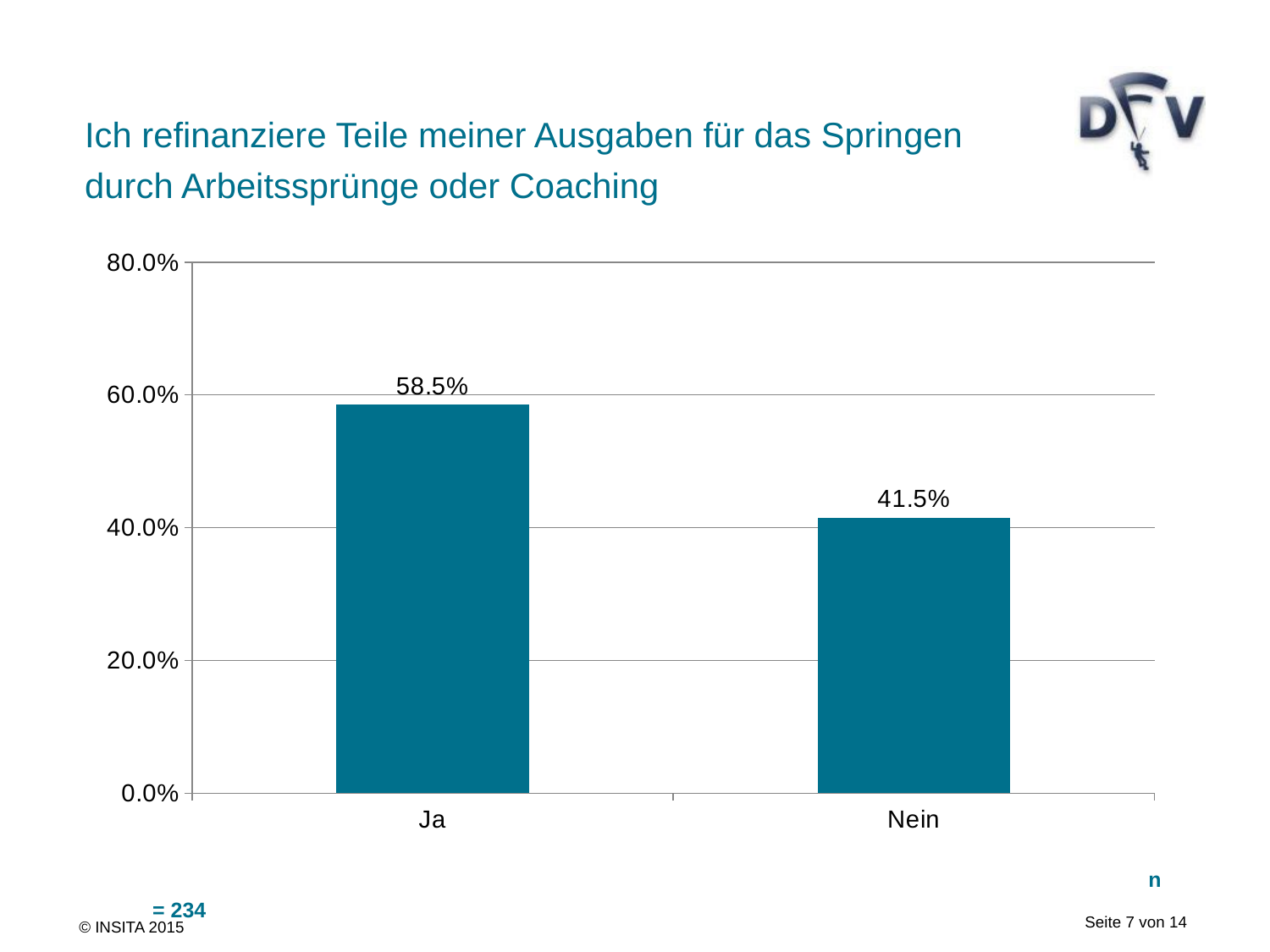
What is the value for "Nein"? 41.5% What is the difference between the values for "Ja" and "Nein"? 17.0% Which is larger, the value for "Ja" or the value for "Nein"? Ja How many categories are shown on the x axis? 2 Which category has the highest value? Ja What kind of chart is shown on the slide? bar chart Is the value for "Nein" greater or less than 40.0%? greater What is the sample size (n) stated on the slide? 234 What is the value for "Ja"? 58.5% Which category has the lowest value? Nein What is the highest value shown on the y axis? 80.0% Is the value for "Ja" greater or less than 60.0%? less